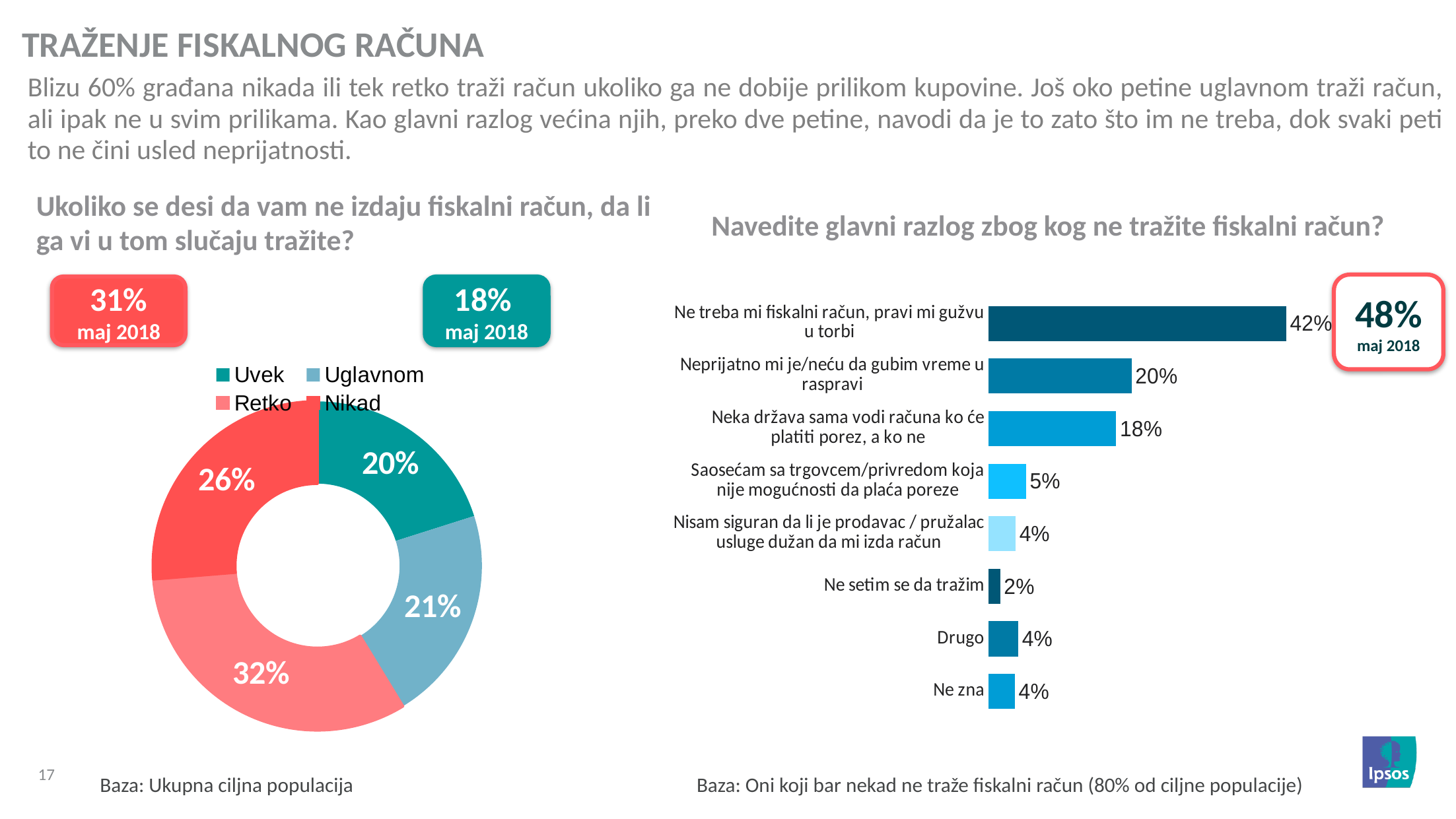
In the bar chart on the right, what is the value for 'Neprijatno mi je/neću da gubim vreme u raspravi'? 20% In the bar chart on the right, how many categories are plotted? 8 In the bar chart on the right, which reason has the lowest value? Ne setim se da tražim In the bar chart on the right, which reason has the highest value? Ne treba mi fiskalni račun, pravi mi gužvu u torbi In the donut chart on the left, what percentage is shown for Retko? 32% In the donut chart on the left, how many categories does the legend list? 4 In the donut chart on the left, which category has the largest share? Retko In the donut chart on the left, what is the difference between the Retko and Nikad shares? 6% In the donut chart on the left, what percentage is shown for Uvek? 20% In the bar chart on the right, what is the difference between 'Ne treba mi fiskalni račun, pravi mi gužvu u torbi' and 'Neka država sama vodi računa ko će platiti porez, a ko ne'? 24% In the donut chart on the left, which category has the smallest share? Uvek What type of chart is shown on the right side of the slide? Bar chart